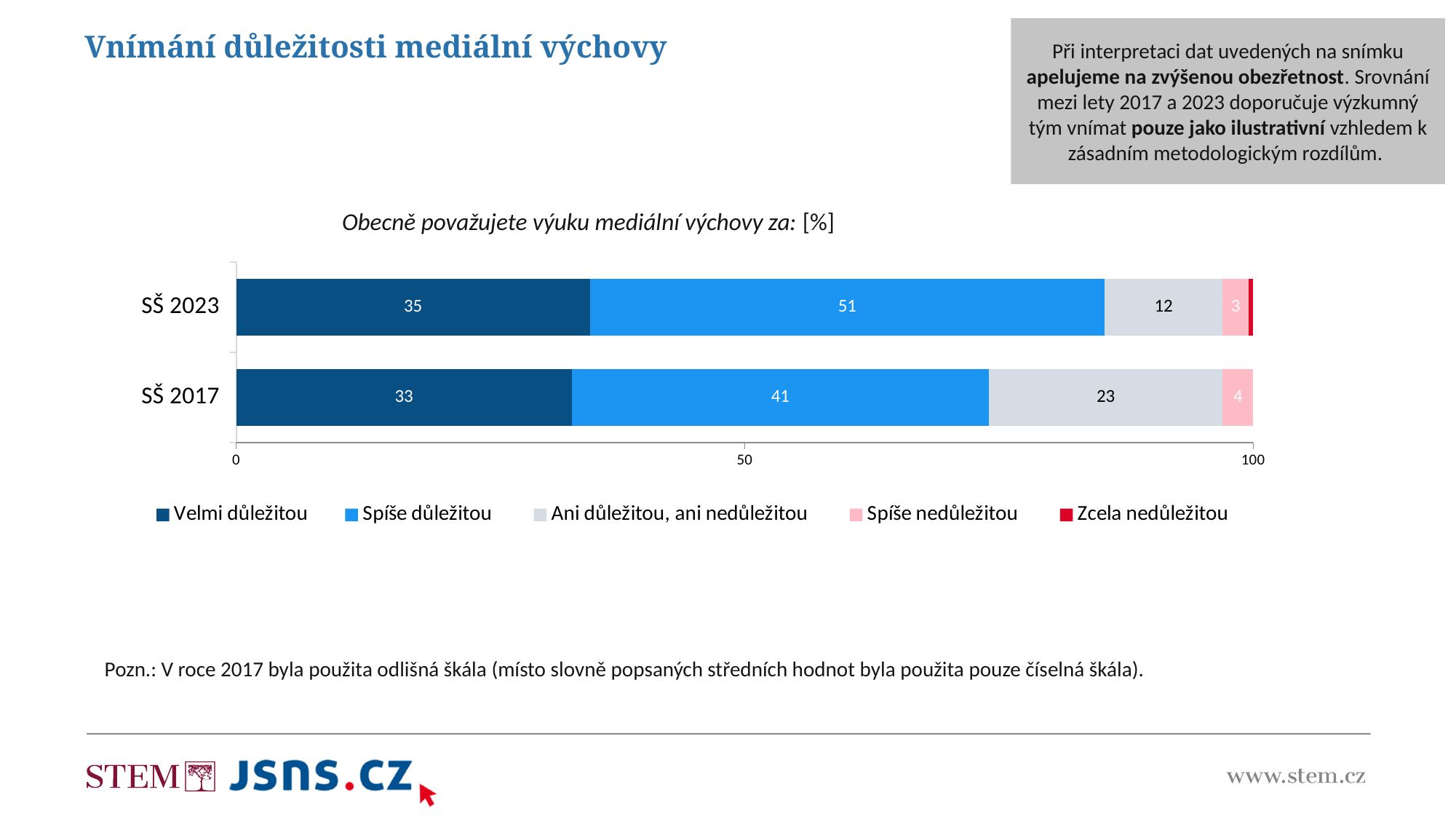
How many bars (categories) are shown in the chart? 2 What is the value for "Ani důležitou, ani nedůležitou" in the SŠ 2017 bar? 23 By how much does the "Spíše důležitou" value for SŠ 2023 exceed that for SŠ 2017? 10 What is the value for "Spíše nedůležitou" in the SŠ 2023 bar? 3 What kind of chart is shown on the slide? Stacked bar chart Which bar has the larger "Velmi důležitou" value, SŠ 2023 or SŠ 2017? SŠ 2023 What is the value for "Velmi důležitou" in the SŠ 2023 bar? 35 What is the question text shown above the chart? Obecně považujete výuku mediální výchovy za: [%] What is the value for "Spíše důležitou" in the SŠ 2017 bar? 41 What is the difference between the "Ani důležitou, ani nedůležitou" values for SŠ 2017 and SŠ 2023? 11 How many series does the legend list? 5 Which response category has the largest segment in the SŠ 2023 bar? Spíše důležitou